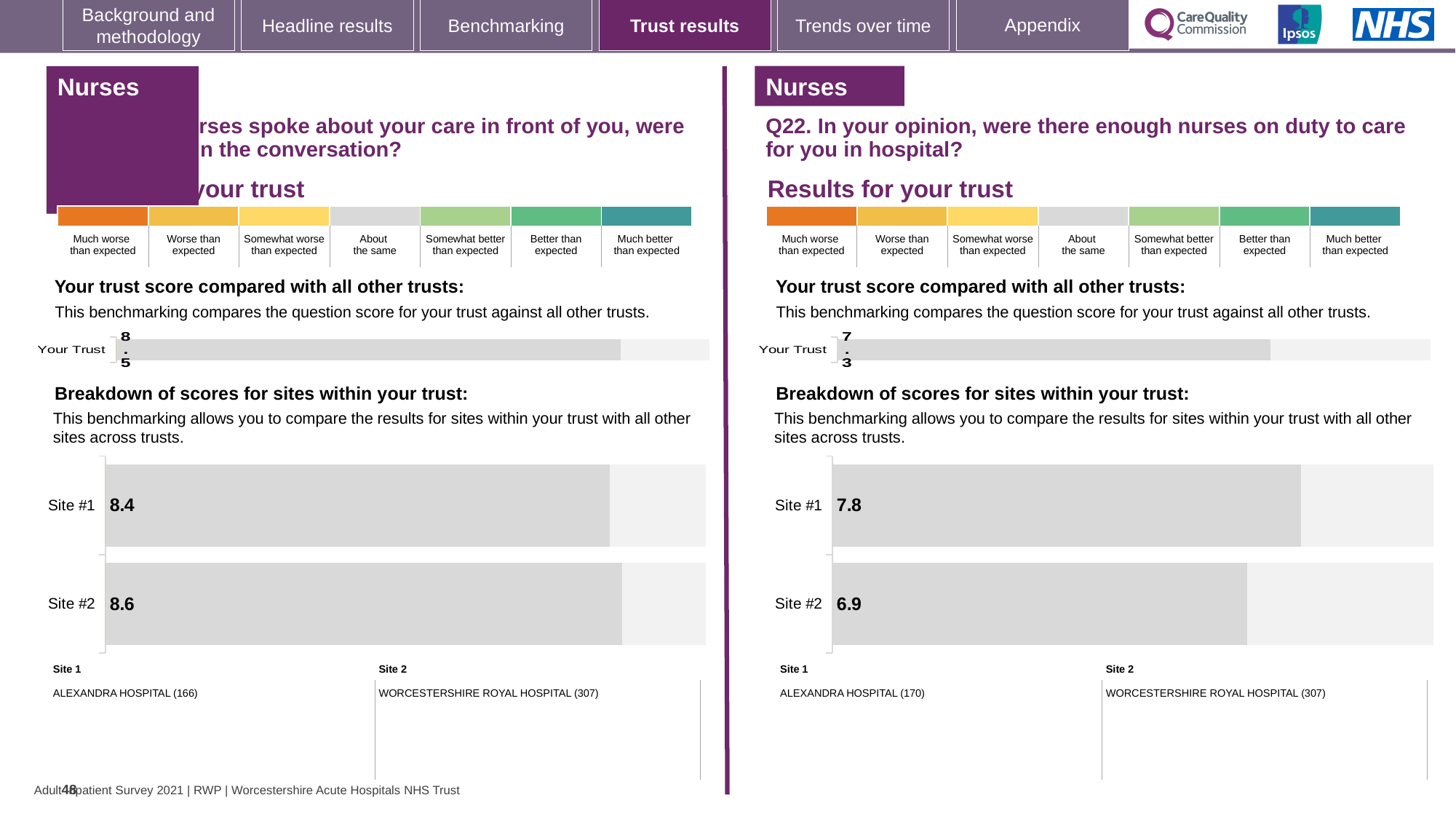
On the right-hand site breakdown chart (Q22), what is the difference between the Site #1 and Site #2 scores? 0.9 On the left-hand site breakdown chart, what is the difference between the Site #2 and Site #1 scores? 0.2 On the right-hand site breakdown chart (Q22), which site has the lower score? Site #2 Is the Site #1 score on the left-hand site breakdown chart larger or smaller than the Site #1 score on the right-hand (Q22) chart? larger On the right-hand chart (Q22), what is the score shown for Your Trust? 7.3 How many sites are shown in the right-hand site breakdown chart (Q22)? 2 On the right-hand site breakdown chart (Q22), what is the score for Site #2? 6.9 On the right-hand site breakdown chart (Q22), what is the score for Site #1? 7.8 On the left-hand site breakdown chart, what is the score for Site #2? 8.6 What type of chart is used for the site breakdown on the right-hand side (Q22)? Bar chart On the left-hand chart, what is the score shown for Your Trust? 8.5 On the left-hand site breakdown chart, which site has the higher score? Site #2